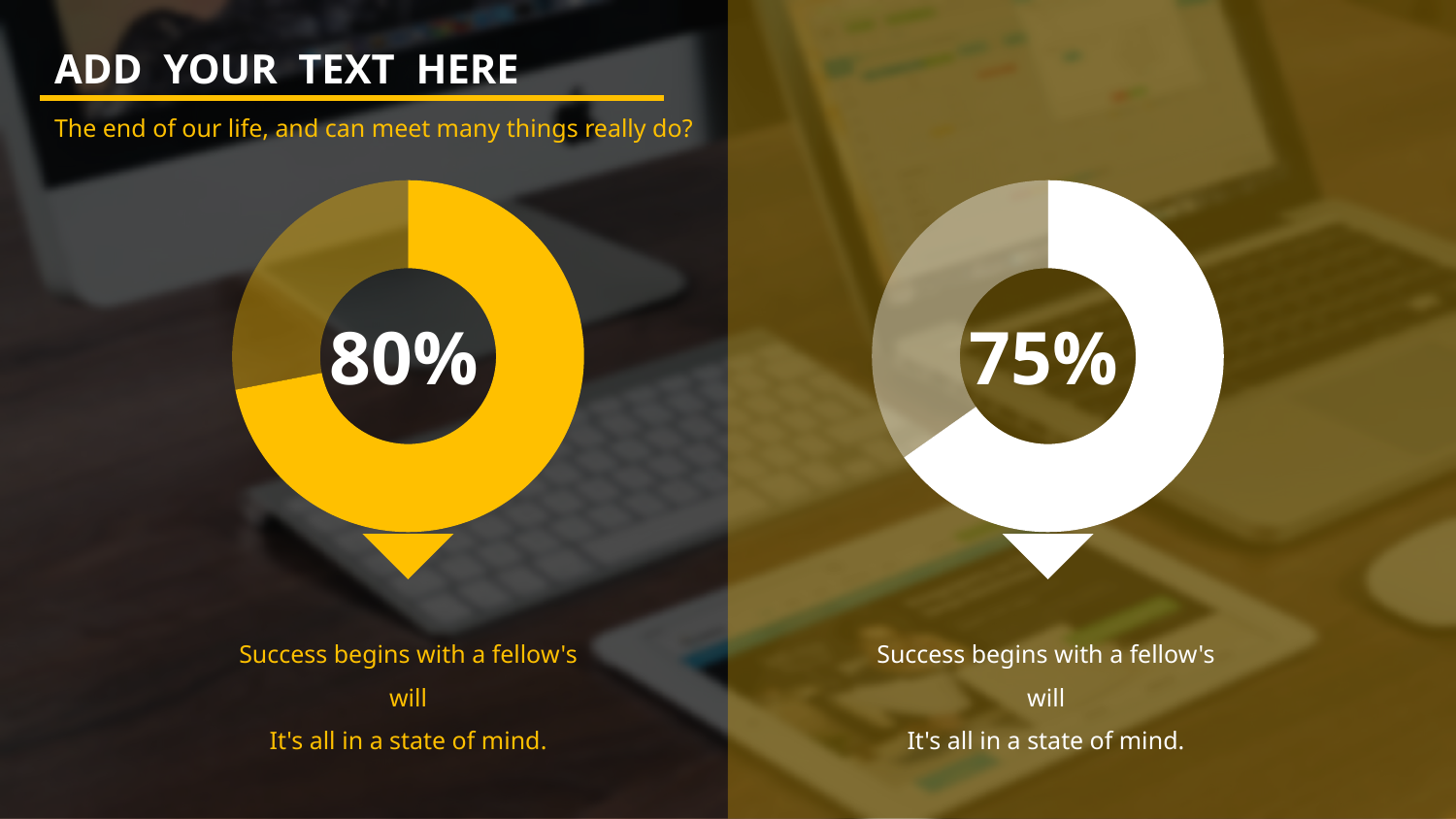
What colour is the larger slice of the left donut chart? yellow Is the percentage shown in the right donut chart greater or less than 50%? greater What percentage is printed in the centre of the right donut chart? 75% What percentage is printed in the centre of the left donut chart? 80% What colour is the larger slice of the right donut chart? white How many donut charts are on the slide? 2 How many slices does the left donut chart have? 2 Which donut chart shows the larger percentage, the left one or the right one? the left one What is the difference between the percentage shown in the left donut chart and the percentage shown in the right donut chart? 5% What kind of chart is shown on the right side of the slide? donut chart What kind of chart is shown on the left side of the slide? donut chart